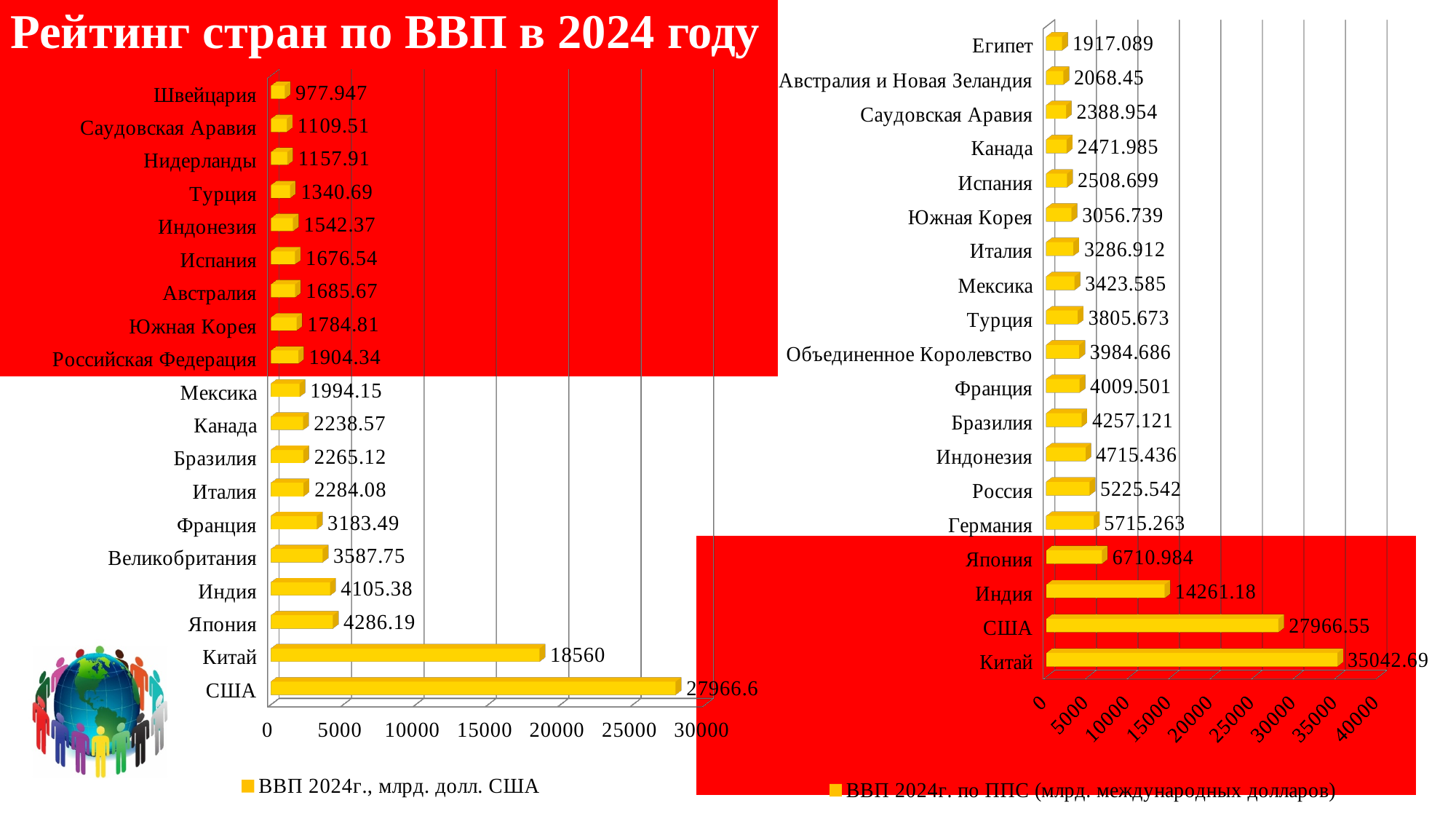
In the left chart (ВВП 2024г., млрд. долл. США), what is the value for Франция? 3183.49 In the right chart (ВВП 2024г. по ППС), which is larger, the value for Япония or the value for Россия? Япония In the right chart (ВВП 2024г. по ППС), which country has the highest value? Китай What type of chart is the left chart (ВВП 2024г., млрд. долл. США)? bar chart What is the legend entry of the right chart? ВВП 2024г. по ППС (млрд. международных долларов) In the left chart (ВВП 2024г., млрд. долл. США), which country has the lowest value? Швейцария In the left chart (ВВП 2024г., млрд. долл. США), what is the difference between the values for США and Китай? 9406.6 In the left chart (ВВП 2024г., млрд. долл. США), how many countries are shown? 19 In the left chart (ВВП 2024г., млрд. долл. США), what is the value for Китай? 18560 In the right chart (ВВП 2024г. по ППС), what is the value for Индия? 14261.18 In the right chart (ВВП 2024г. по ППС), what is the difference between the values for Китай and США? 7076.14 In the right chart (ВВП 2024г. по ППС), what is the value for Германия? 5715.263